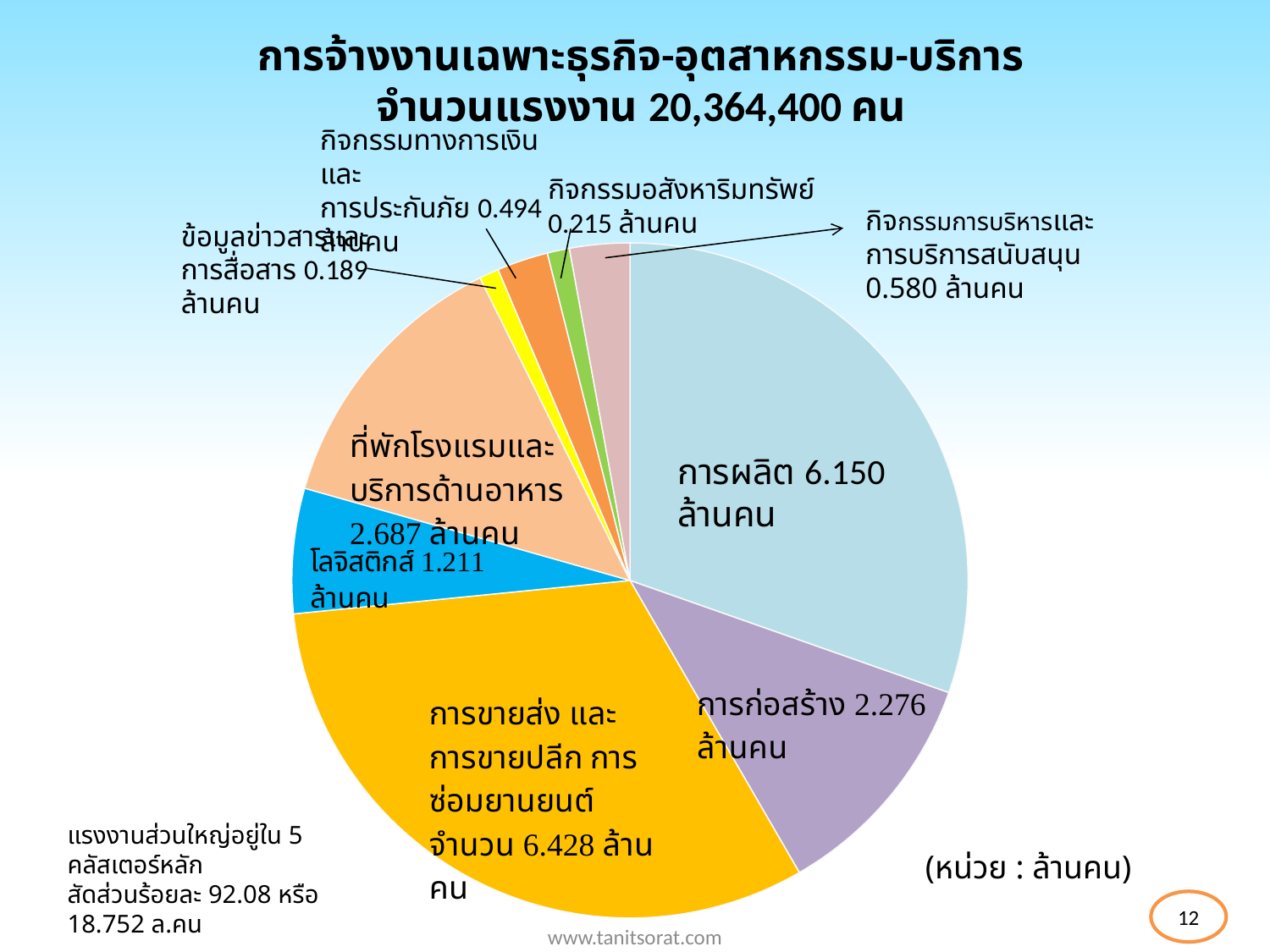
What is the difference between the values for การขายส่ง และการขายปลีก การซ่อมยานยนต์ and การผลิต? 0.278 ล้านคน What is the value shown for โลจิสติกส์? 1.211 ล้านคน What total number of workers is stated in the chart title? 20,364,400 คน How many slices does the pie chart have? 9 What is the value shown for ที่พักโรงแรมและบริการด้านอาหาร? 2.687 ล้านคน What kind of chart is shown on the slide? Pie chart Which category has the largest slice of the pie? การขายส่ง และการขายปลีก การซ่อมยานยนต์ (6.428 ล้านคน) Which category has the smallest slice of the pie? ข้อมูลข่าวสารและการสื่อสาร (0.189 ล้านคน) What is the value shown for การผลิต? 6.150 ล้านคน Which is larger, the value for กิจกรรมทางการเงินและการประกันภัย or the value for กิจกรรมอสังหาริมทรัพย์? กิจกรรมทางการเงินและการประกันภัย What is the value shown for การก่อสร้าง? 2.276 ล้านคน What is the value shown for กิจกรรมการบริหารและการบริการสนับสนุน? 0.580 ล้านคน